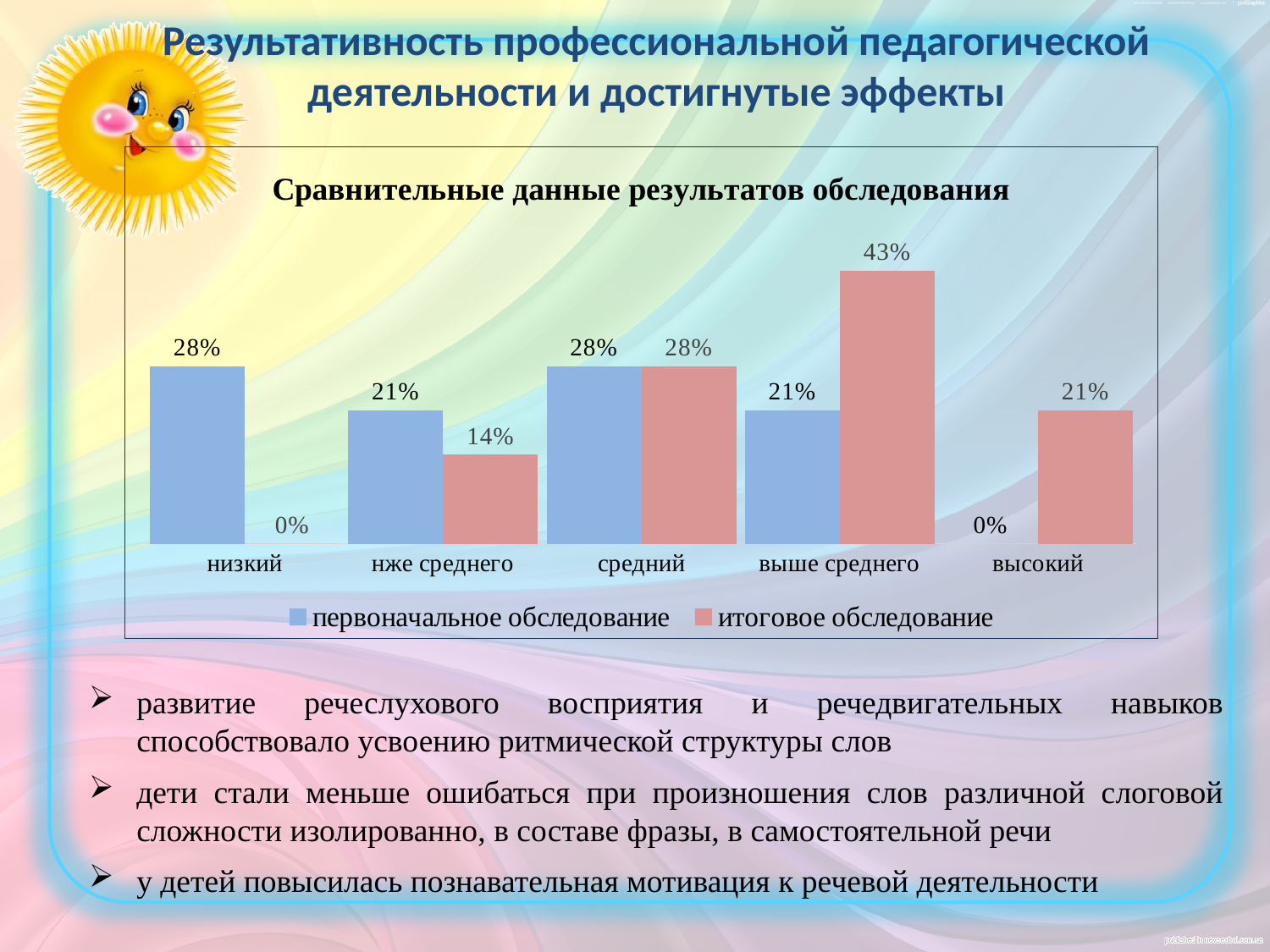
In the «нже среднего» category, which series has the larger value: «первоначальное обследование» or «итоговое обследование»? первоначальное обследование What is the value for «первоначальное обследование» in the «высокий» category? 0% What is the value for «первоначальное обследование» in the «низкий» category? 28% How many categories are shown on the x axis? 5 What is the title of the chart? Сравнительные данные результатов обследования Which category has the highest value for «итоговое обследование»? выше среднего What kind of chart is shown on the slide? bar chart What is the value for «итоговое обследование» in the «выше среднего» category? 43% Which category has the lowest value for «итоговое обследование»? низкий How many series does the legend list? 2 What is the value for «итоговое обследование» in the «нже среднего» category? 14% What is the difference between «итоговое обследование» and «первоначальное обследование» in the «выше среднего» category? 22%